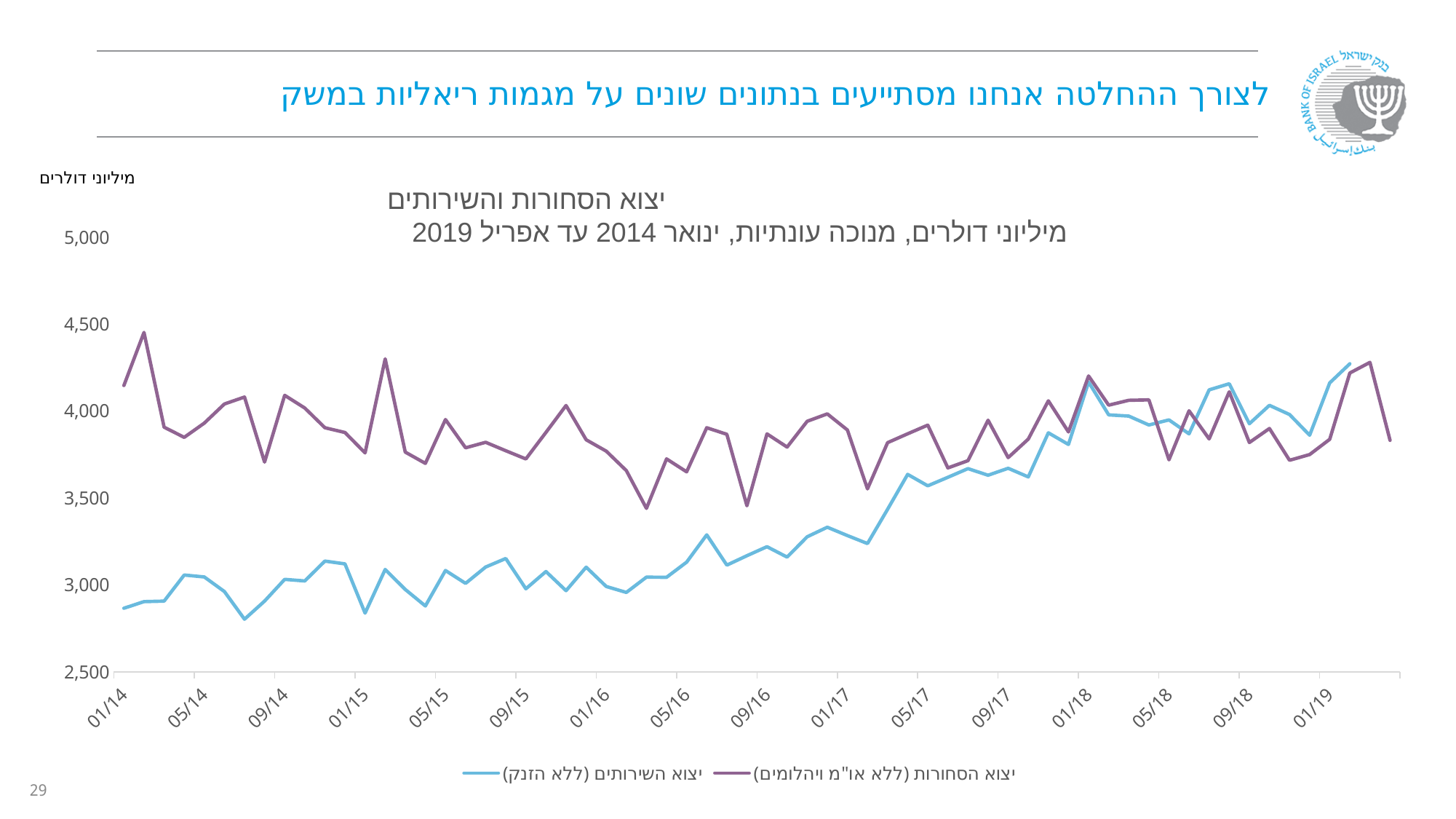
Is the value of goods exports (יצוא הסחורות) at 05/16 greater or less than 4,000? less At 01/14, which series has the higher value: goods exports or services exports? goods exports (יצוא הסחורות) How many series does the legend list? 2 What is the title of the chart? יצוא הסחורות והשירותים What unit label is shown above the vertical axis? מיליוני דולרים Is the final plotted value of services exports (יצוא השירותים (ללא הזנק)) greater or less than 4,000? greater Is the value of services exports (יצוא השירותים (ללא הזנק)) at 01/14 greater or less than 3,000? less What kind of chart is shown on the slide? line chart Does the services exports series (יצוא השירותים (ללא הזנק)) rise or fall overall from 01/14 to 01/19? rise How many tick labels are shown on the horizontal axis? 16